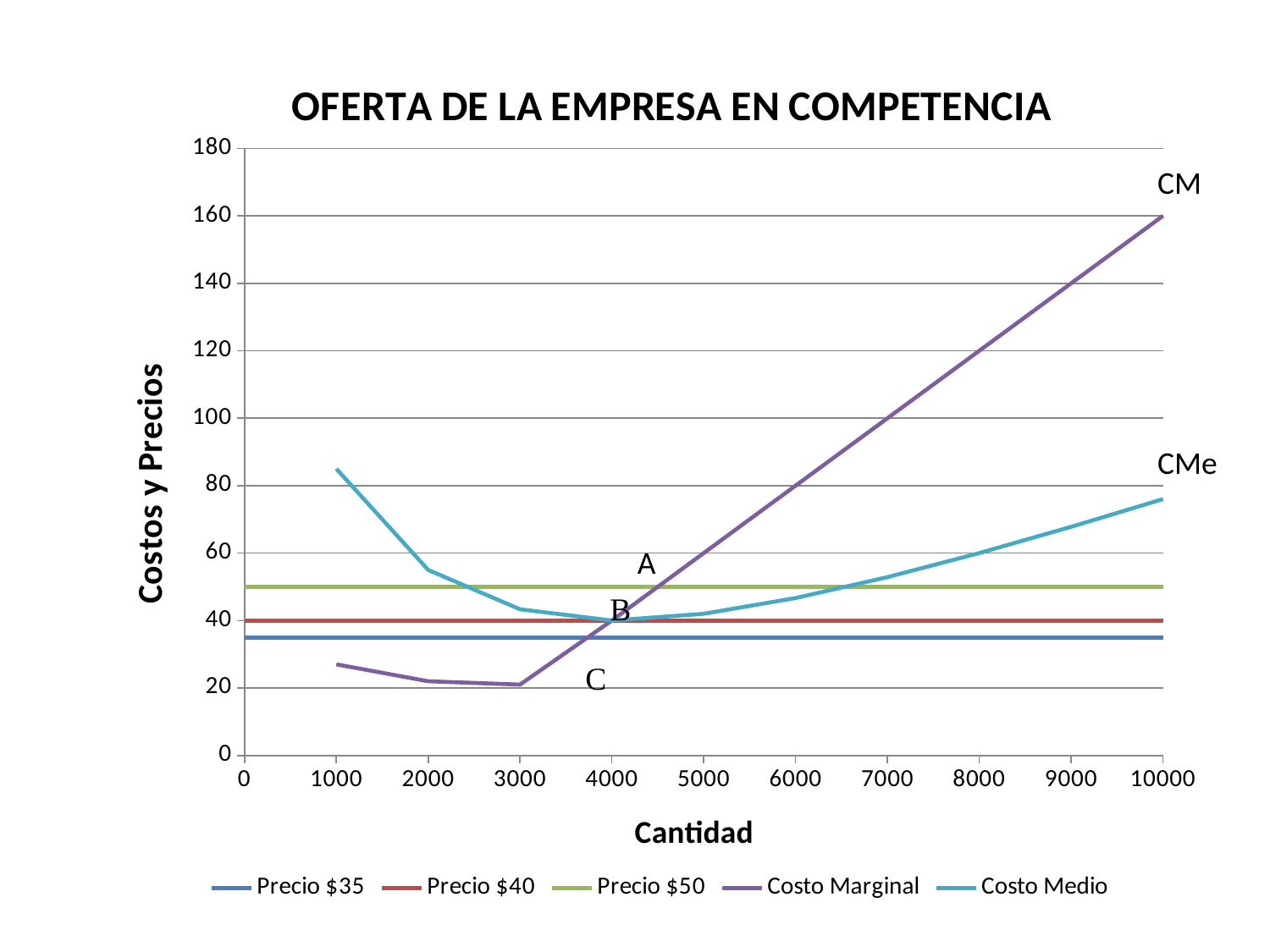
How many series does the legend list? 5 What is the value of Costo Marginal at a Cantidad of 10000? 160 What is the title of the chart? OFERTA DE LA EMPRESA EN COMPETENCIA At what constant value does the Precio $40 line sit on the vertical axis? 40 Does the Costo Marginal series rise or fall between a Cantidad of 3000 and 10000? rise At a Cantidad of 10000, which is larger: Costo Marginal or Costo Medio? Costo Marginal What kind of chart is shown on the slide? line chart Is the value of Costo Medio at a Cantidad of 6000 greater or less than 60? less What is the label of the horizontal axis? Cantidad Is the value of Costo Marginal at a Cantidad of 2000 greater or less than 40? less Is the value of Costo Medio at a Cantidad of 1000 greater or less than 80? greater At a Cantidad of 1000, which is larger: Costo Medio or Costo Marginal? Costo Medio